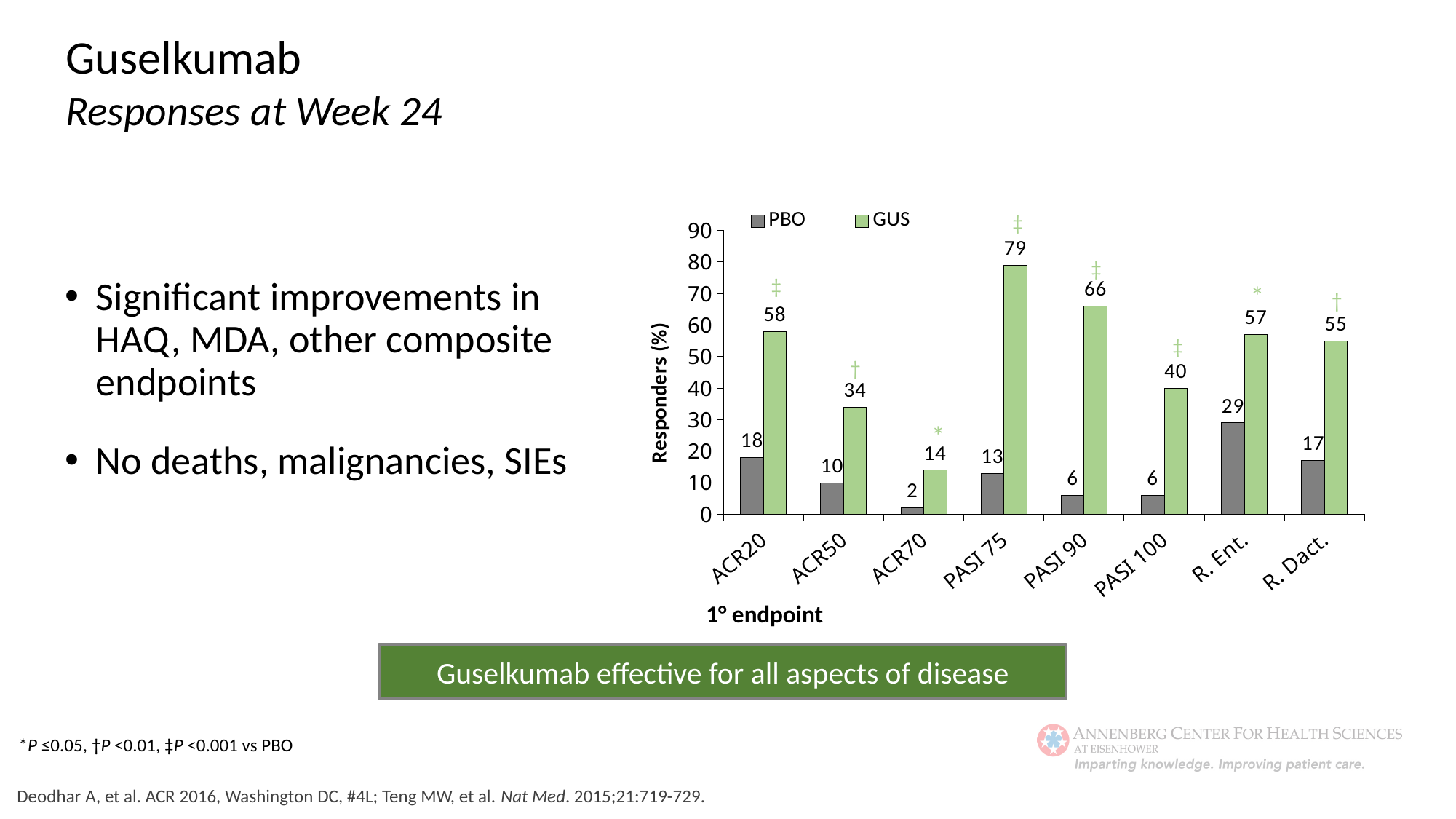
What is the GUS value for PASI 75? 79 Is the GUS value for PASI 90 greater or less than 60? greater What is the difference between the GUS and PBO values for ACR50? 24 How many endpoints are shown on the x axis? 8 What is the label of the y axis? Responders (%) What is the PBO value for ACR20? 18 What is the GUS value for R. Dact.? 55 Which is larger, the PBO value for R. Ent. or the PBO value for R. Dact.? R. Ent. What kind of chart is shown? bar chart How many series does the legend list? 2 Which endpoint has the highest GUS value? PASI 75 Which endpoint has the lowest PBO value? ACR70